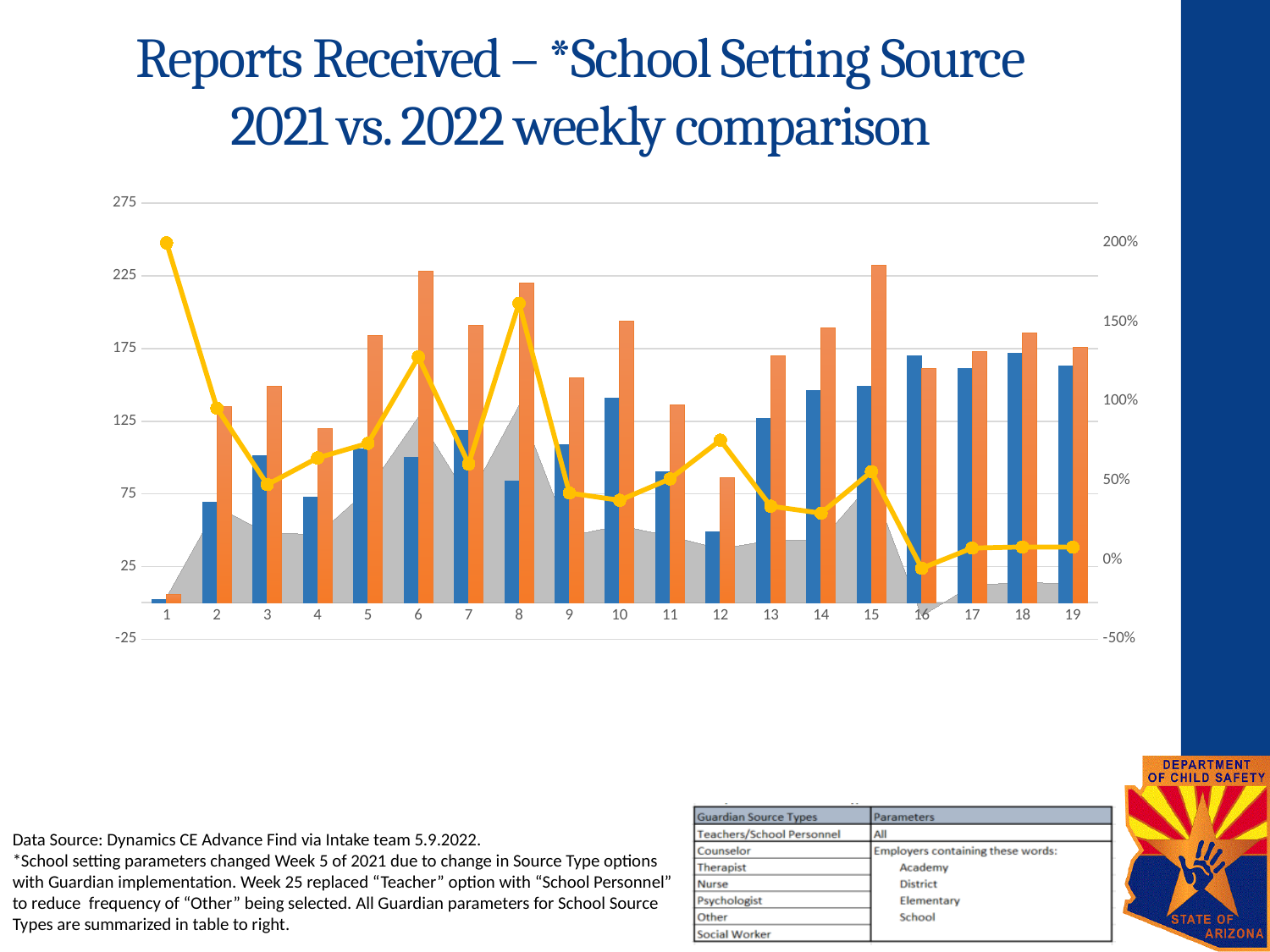
Is the value of the blue bar for week 16 greater or less than 125? greater At which week is the orange bar the lowest? 1 At which week is the blue bar the lowest? 1 How many weeks (categories) are shown on the x axis of the chart? 19 Does the yellow line generally rise or fall from week 1 to week 19? Fall Is the value of the yellow line for week 13 greater or less than 50%? less Is the value of the orange bar for week 6 greater or less than 200? greater What is the title of the slide containing the chart? Reports Received – *School Setting Source 2021 vs. 2022 weekly comparison For week 2, which bar is taller, the blue bar or the orange bar? Orange bar At which week does the yellow line reach its highest value? 1 What kind of chart is shown on the slide? Combination area, bar and line chart